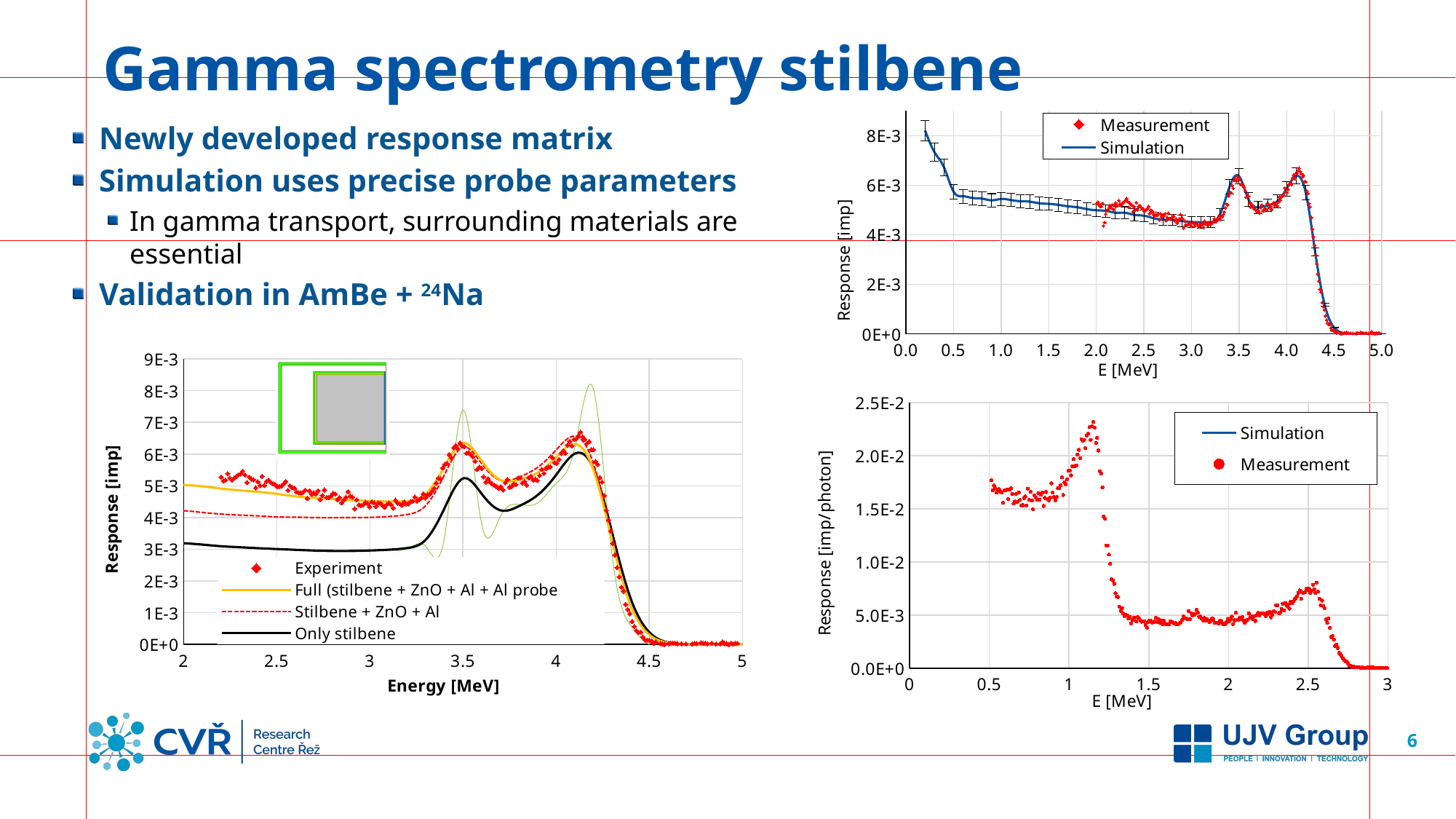
In the top-right chart, is the Simulation value at 1.0 MeV greater or less than 4E-3? greater In the bottom-left chart, is the 'Only stilbene' value at 2.5 MeV greater or less than 4E-3? less How many charts are shown on the slide? 3 In the bottom-right chart, is the Measurement value at about 1.15 MeV greater or less than 2.0E-2? greater In the bottom-right chart, does the Measurement series rise or fall between 1.2 MeV and 1.5 MeV? fall In the bottom-left chart, how many series does the legend list? 4 In the bottom-left chart, what is the label of the x axis? Energy [MeV] In the top-right chart, how many series does the legend list? 2 In the bottom-left chart, do the curves rise or fall between 4.2 MeV and 4.5 MeV? fall